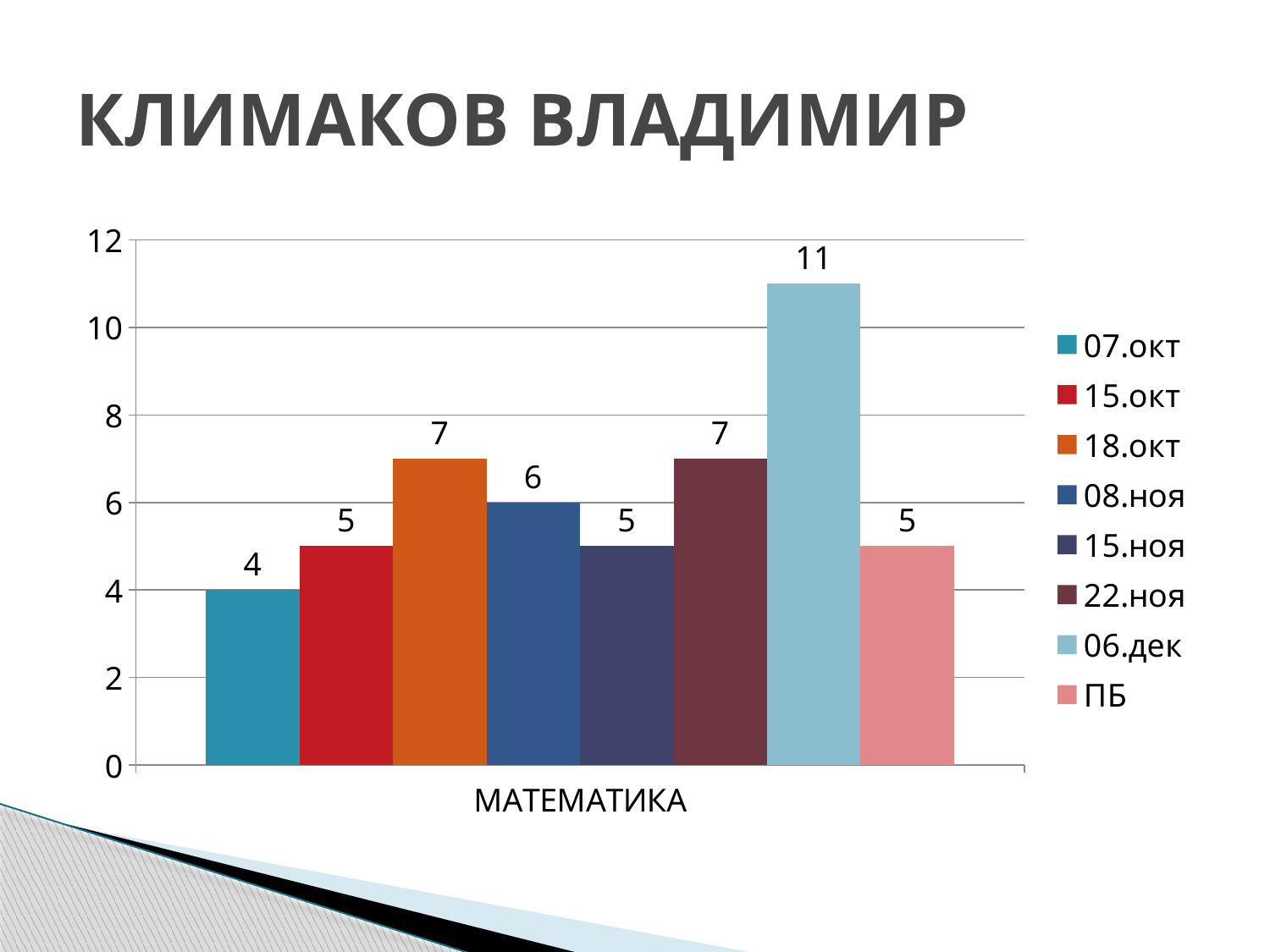
What is the value for the ПБ series? 5 Which is larger, the value for 18.окт or the value for 15.ноя? 18.окт What is the value for the 08.ноя series? 6 What is the difference between the 06.дек value and the 07.окт value? 7 What is the value for the 06.дек series? 11 What kind of chart is shown on the slide? bar chart What is the value for the 07.окт series in the МАТЕМАТИКА chart? 4 Which series has the lowest value? 07.окт What is the category label shown on the x axis? МАТЕМАТИКА Is the value for 06.дек greater or less than 10? greater How many series does the legend list? 8 Which series has the highest value? 06.дек